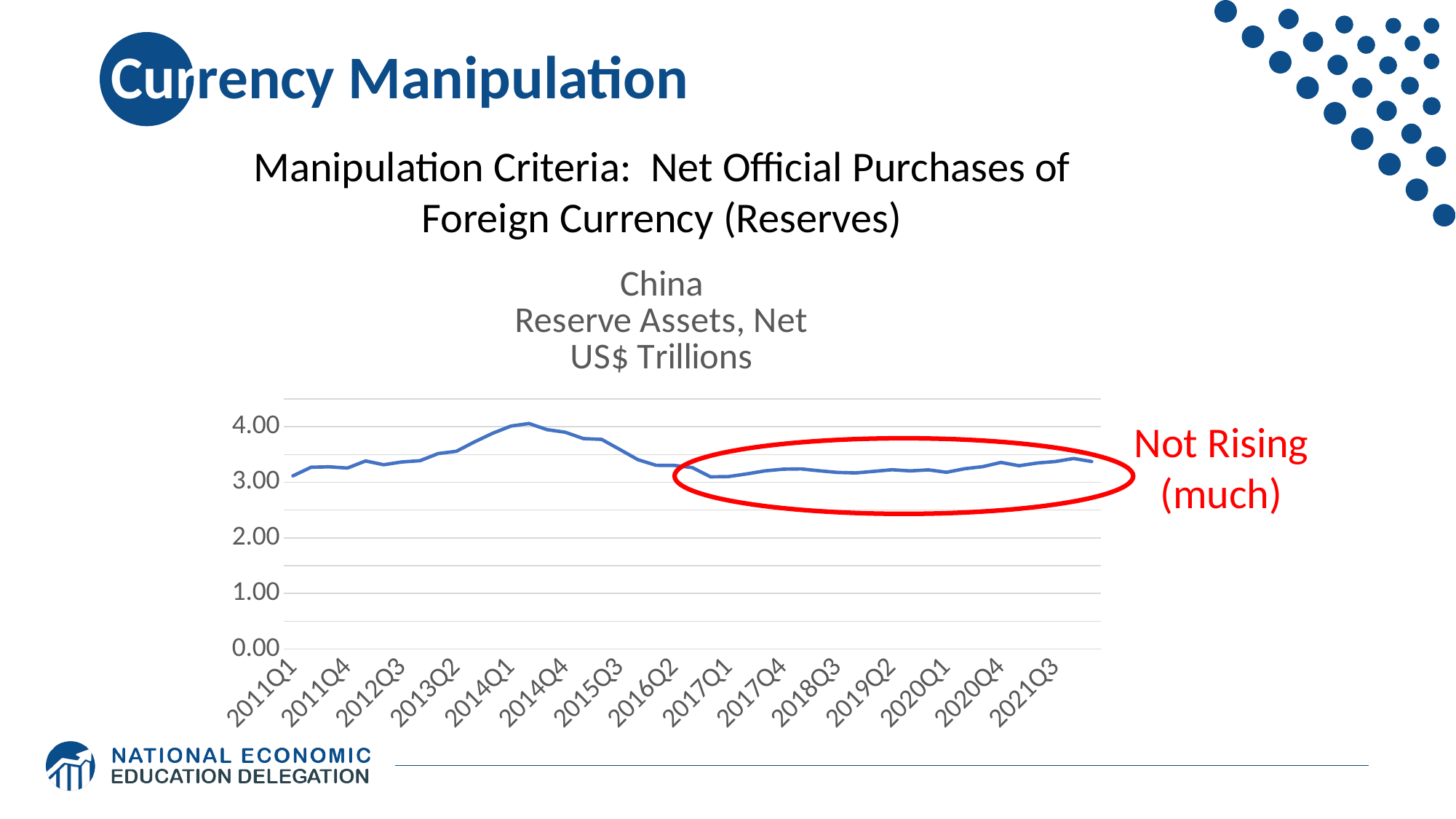
What kind of chart is shown on the slide? Line chart What is the title of the chart? China Reserve Assets, Net US$ Trillions Is the value for 2016Q2 greater or less than 4.00? less Is the value for 2011Q4 greater or less than 3.00? greater Which is larger, the value for 2014Q1 or the value for 2017Q1? 2014Q1 In what units are the values on the chart expressed? US$ Trillions Which is larger, the value for 2011Q1 or the value for 2013Q2? 2013Q2 Does the line rise or fall between 2014Q4 and 2016Q2? Falls Is the value for 2013Q2 greater or less than 3.00? greater Does the line rise or fall between 2011Q1 and 2014Q1? Rises